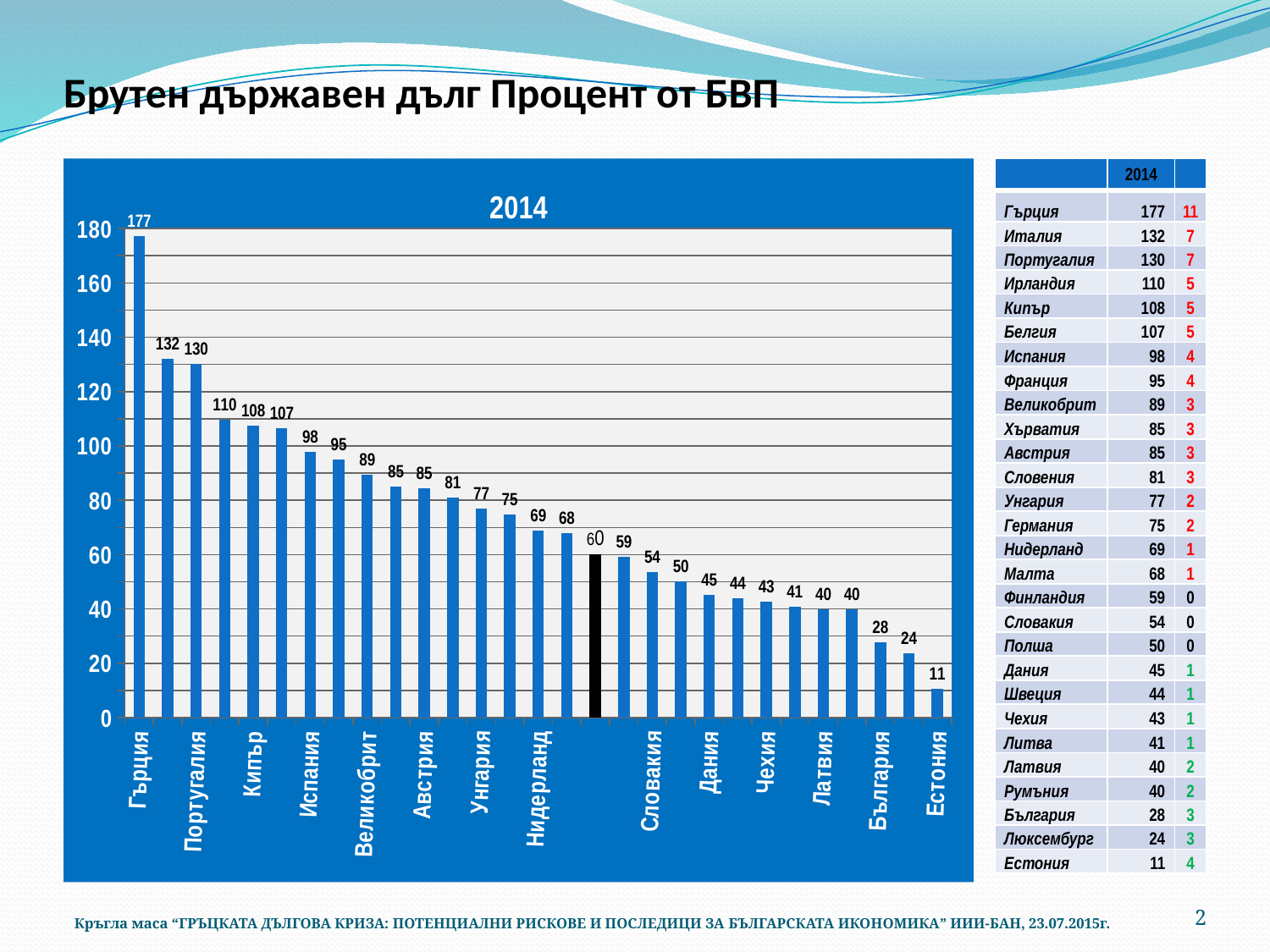
What is the value for Гърция? 177 What type of chart is shown on the slide? bar chart Is the value for Португалия greater or less than 120? greater Which has a larger value, Испания or Австрия? Испания Do the values generally rise or fall from left to right along the x axis? fall Which country has the lowest value in the chart? Естония What is the value for Кипър? 108 What value is labelled on the single black bar in the chart? 60 What is the title of the chart? 2014 Which country has the highest value in the chart? Гърция What is the value for България? 28 What is the difference between the values for Гърция and България? 149